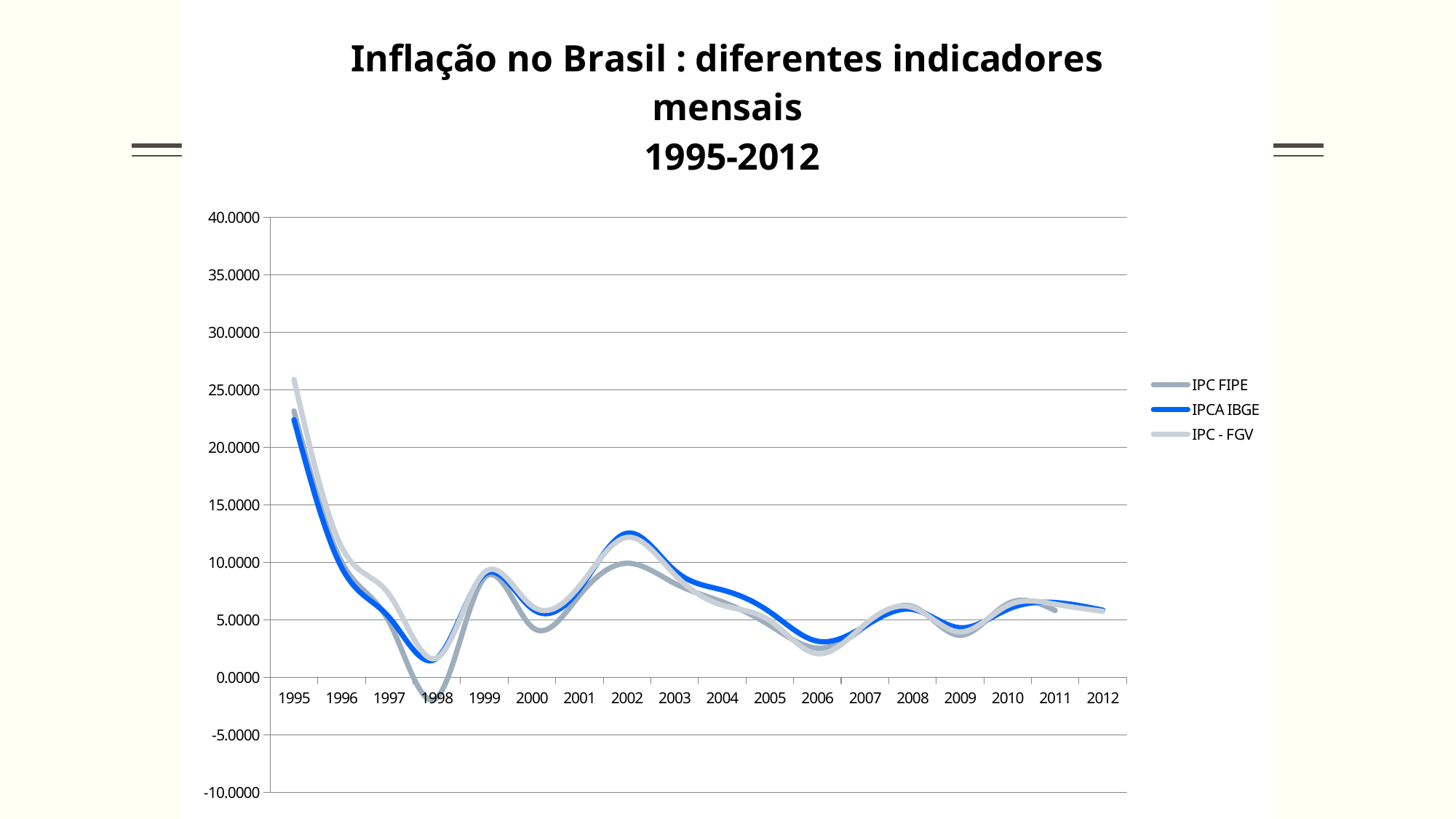
What is the title of the chart? Inflação no Brasil : diferentes indicadores mensais 1995-2012 In which year is the IPCA IBGE value highest? 1995 Do the IPCA IBGE values rise or fall from 1995 to 1998? fall How many years are shown along the x axis? 18 Is the IPC FIPE value for 1998 greater or less than 0.0000? less In 1995, which series has the higher value, IPC - FGV or IPCA IBGE? IPC - FGV How many series does the legend list? 3 Which series is drawn in dark blue? IPCA IBGE Is the IPCA IBGE value for 2002 greater or less than 10.0000? greater In which year is the IPC FIPE value lowest? 1998 What kind of chart is shown on the slide? line chart Is the IPCA IBGE value for 1995 greater or less than 20.0000? greater